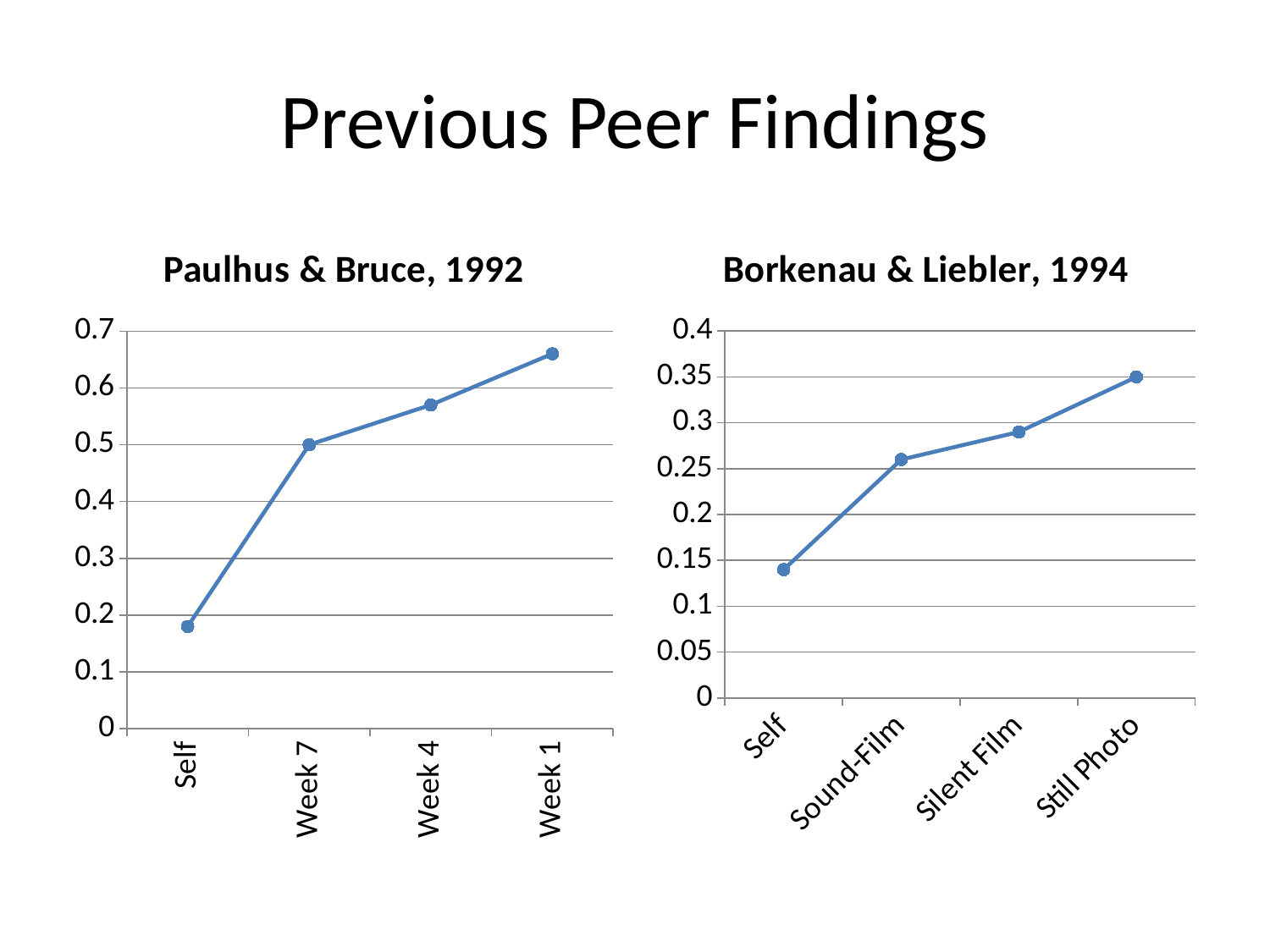
In the Borkenau & Liebler, 1994 chart, what is the value for Still Photo? 0.35 In the Borkenau & Liebler, 1994 chart, is the value for Self greater or less than 0.15? less What kind of chart is the Paulhus & Bruce, 1992 chart? Line chart In the Borkenau & Liebler, 1994 chart, which category has the highest value? Still Photo In the Borkenau & Liebler, 1994 chart, which is larger, the value for Sound-Film or the value for Still Photo? Still Photo How many categories are shown on the x axis of the Borkenau & Liebler, 1994 chart? 4 In the Paulhus & Bruce, 1992 chart, what is the value for Week 7? 0.5 In the Paulhus & Bruce, 1992 chart, is the value for Week 1 greater or less than 0.6? greater In the Paulhus & Bruce, 1992 chart, which category has the lowest value? Self In the Paulhus & Bruce, 1992 chart, is the value for Self greater or less than 0.2? less In the Paulhus & Bruce, 1992 chart, which category has the highest value? Week 1 In the Borkenau & Liebler, 1994 chart, which category has the lowest value? Self